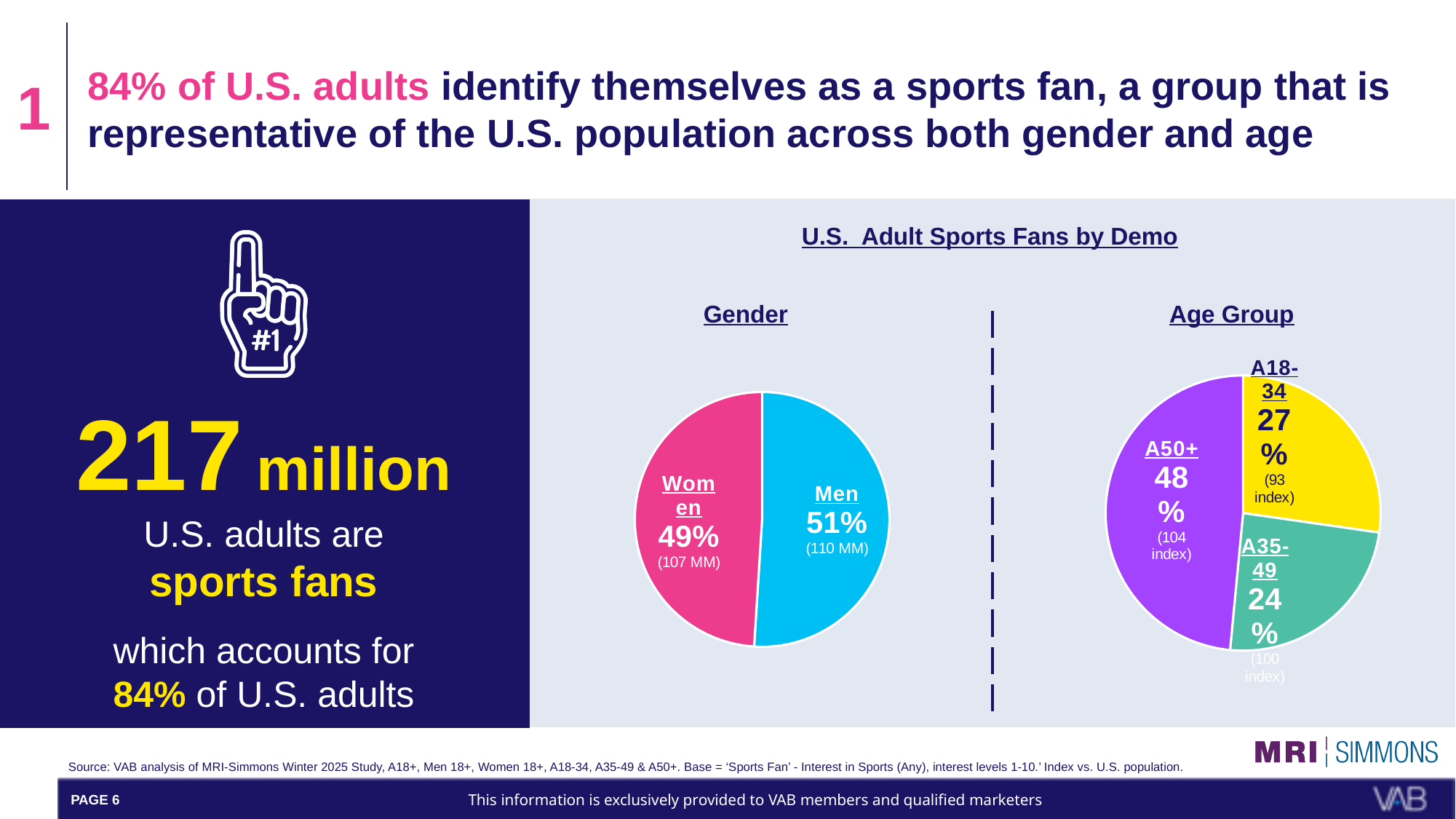
In the Gender pie chart, how many millions of sports fans are women? 107 MM In the Age Group pie chart, which age group has the largest share? A50+ What type of chart is used for the Gender breakdown? Pie chart In the Age Group pie chart, which age group has the smallest share? A35-49 In the Gender pie chart, which slice is larger, Men or Women? Men In the Gender pie chart, what share of U.S. adult sports fans are women? 49% In the Age Group pie chart, what share of sports fans are A35-49? 24% In the Gender pie chart, what share of U.S. adult sports fans are men? 51% How many slices does the Age Group pie chart have? 3 In the Age Group pie chart, what is the index shown for A18-34? 93 index In the Age Group pie chart, what is the difference in percentage points between the A50+ share and the A18-34 share? 21 percentage points In the Age Group pie chart, what share of sports fans are A50+? 48%